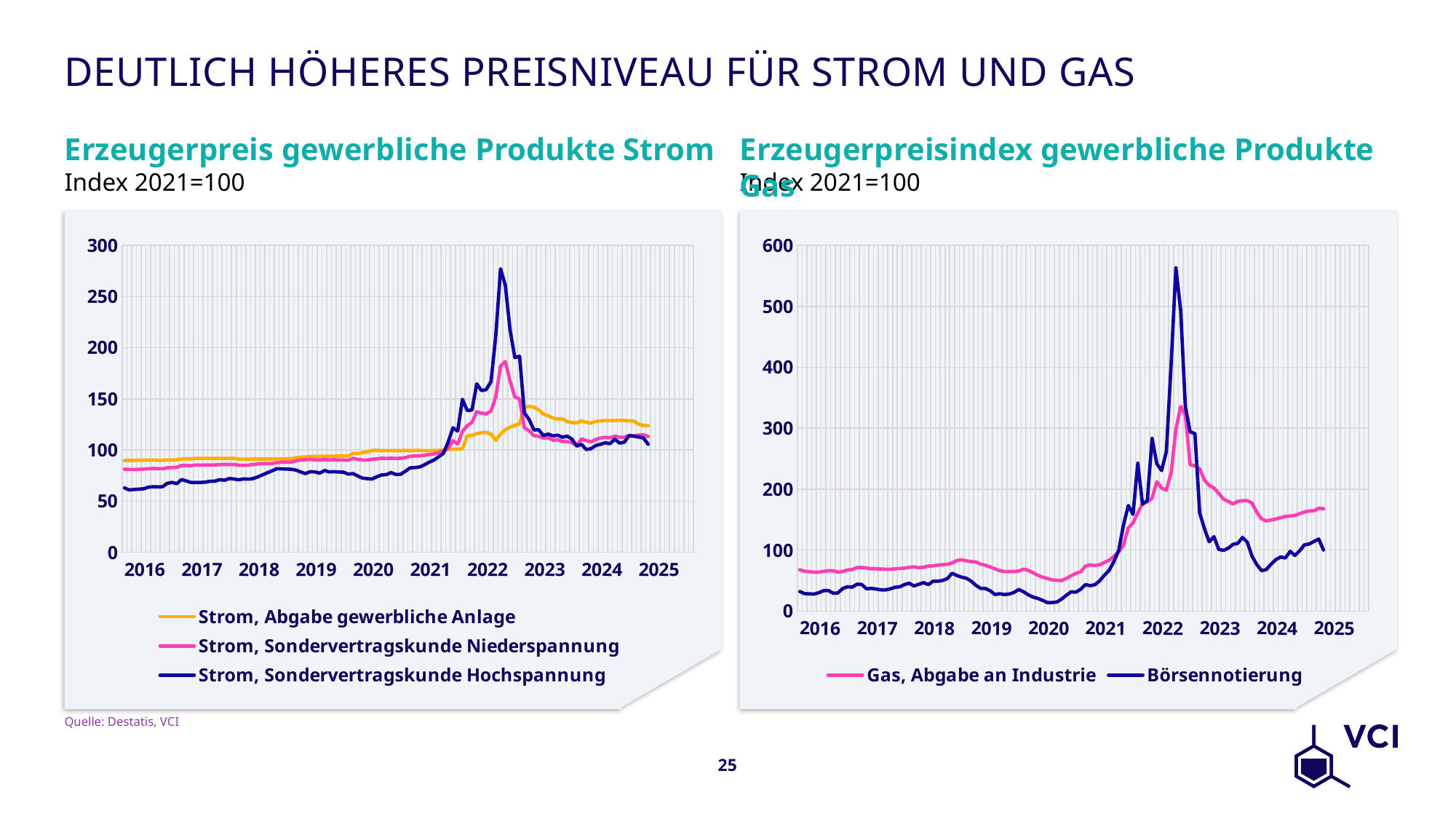
In the right chart (Gas), which series reaches the highest peak? Börsennotierung How many year labels are shown on the x axis of the right chart (Gas)? 10 How many series does the legend of the left chart (Strom) list? 3 In the left chart (Strom), is the value of Strom, Sondervertragskunde Hochspannung at the start of 2016 greater or less than 100? less In the left chart (Strom), which series reaches the highest peak? Strom, Sondervertragskunde Hochspannung In the left chart (Strom), is the peak value of Strom, Sondervertragskunde Hochspannung greater or less than 250? greater How many series does the legend of the right chart (Gas) list? 2 What base year is used for the index in both charts? 2021=100 In the right chart (Gas), does the Börsennotierung series rise or fall between its 2022 peak and 2023? fall In the right chart (Gas), is the peak value of Gas, Abgabe an Industrie greater or less than 400? less What kind of chart is the left chart titled "Erzeugerpreis gewerbliche Produkte Strom"? Line chart